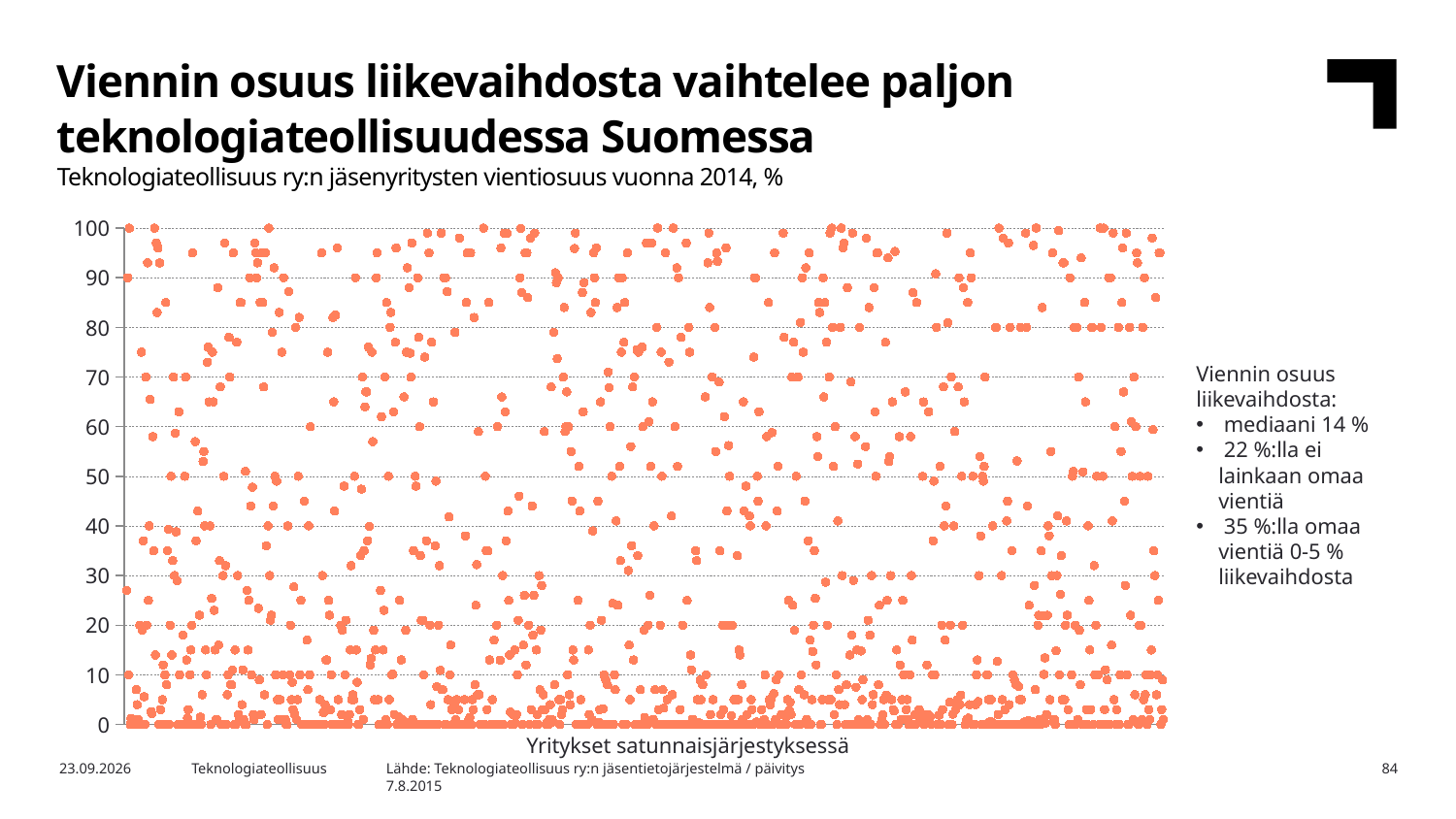
What is the lowest value plotted on the chart? 0 According to the text next to the chart, what share of companies have exports of 0-5 % of turnover? 35 % What is the label of the x axis of the chart? Yritykset satunnaisjärjestyksessä What is the highest value plotted on the chart? 100 According to the text next to the chart, what is the median export share of turnover? 14 % What is the maximum value shown on the y axis of the chart? 100 According to the text next to the chart, what share of companies have no exports at all? 22 % Do the plotted values show a clear rising or falling trend along the x axis? no What kind of chart is shown on the slide? scatter chart